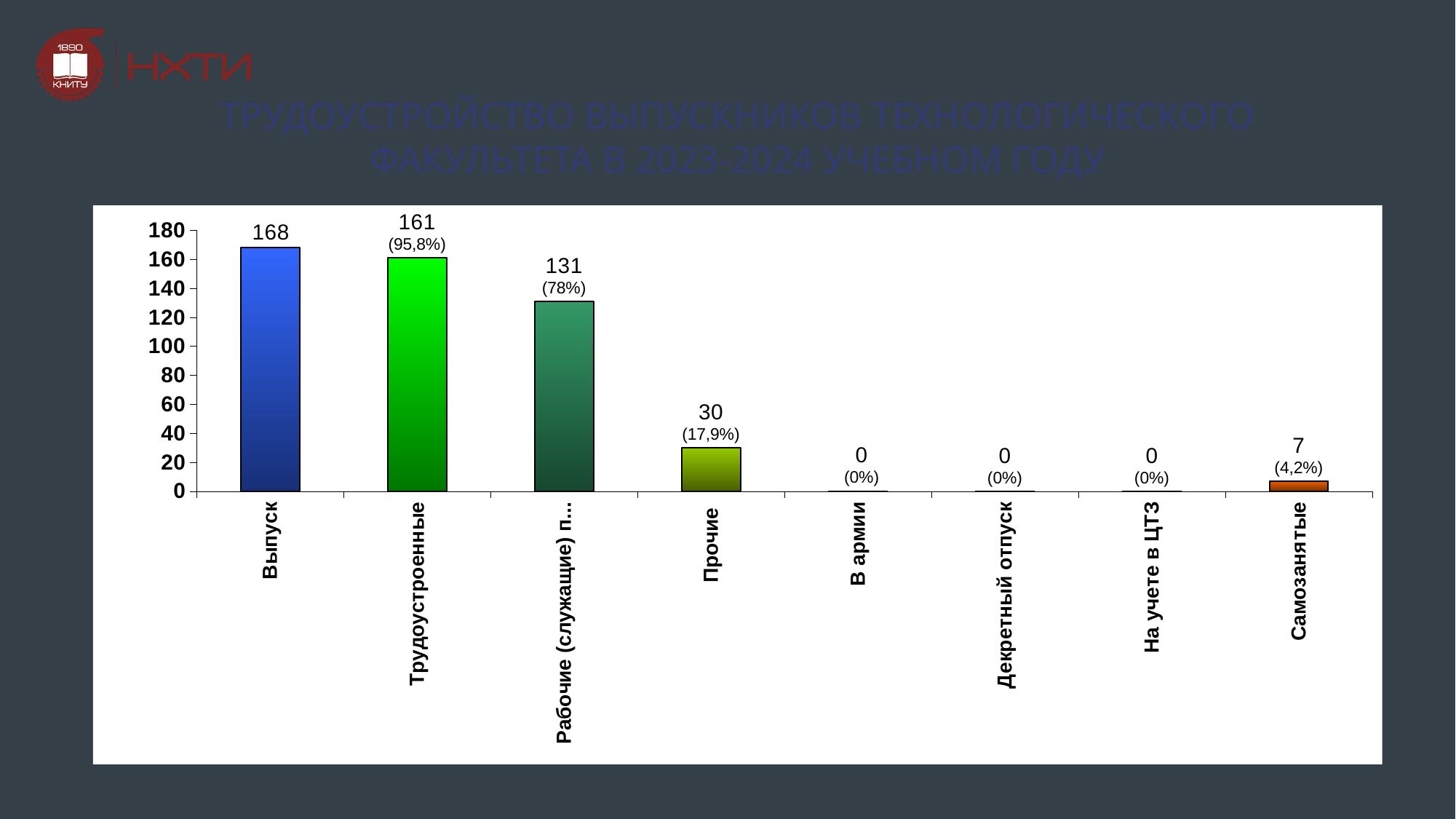
What percentage is shown for Самозанятые? 4,2% What kind of chart is shown on the slide? Bar chart What percentage is shown for Трудоустроенные? 95,8% Which is larger, the value for Прочие or the value for Самозанятые? Прочие Which category has the highest value? Выпуск What is the value for Трудоустроенные? 161 What is the value for Самозанятые? 7 What is the value for Выпуск? 168 What is the value for Прочие? 30 What is the difference between the values for Выпуск and Трудоустроенные? 7 How many categories have a value of 0? 3 How many categories are shown on the x axis? 8